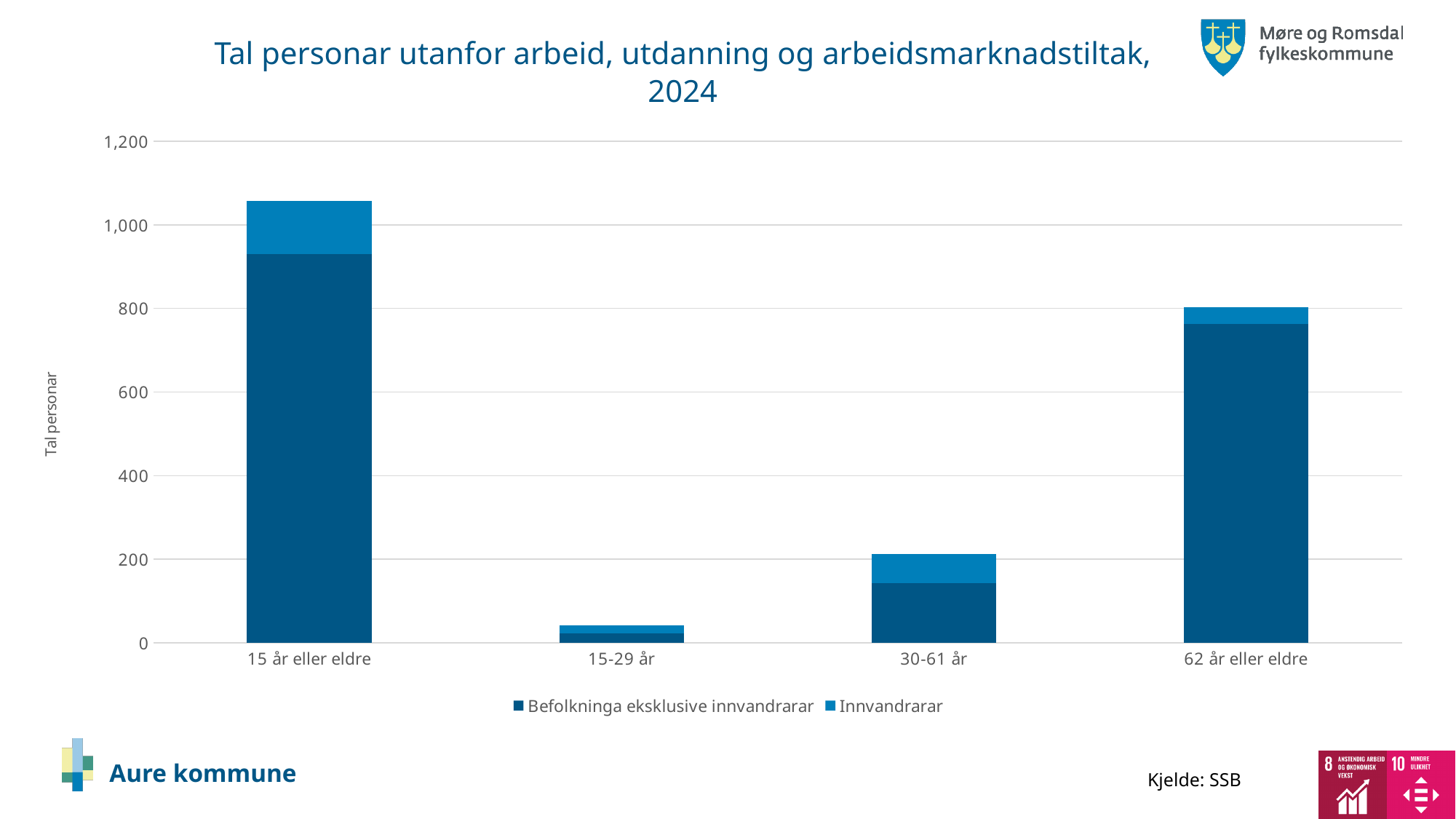
Is the total stacked value for 15-29 år greater or less than 200? less Is the value of Befolkninga eksklusive innvandrarar for 62 år eller eldre greater or less than 600? greater Which category has the shortest stacked bar? 15-29 år What kind of chart is shown on the slide? Stacked bar chart Which category has the tallest stacked bar? 15 år eller eldre How many series does the legend list? 2 Is the total stacked value for 15 år eller eldre greater or less than 1,000? greater How many age categories are shown on the x axis? 4 What is the title of the chart? Tal personar utanfor arbeid, utdanning og arbeidsmarknadstiltak, 2024 What is the label on the y axis? Tal personar Which stacked bar is taller: 62 år eller eldre or 30-61 år? 62 år eller eldre